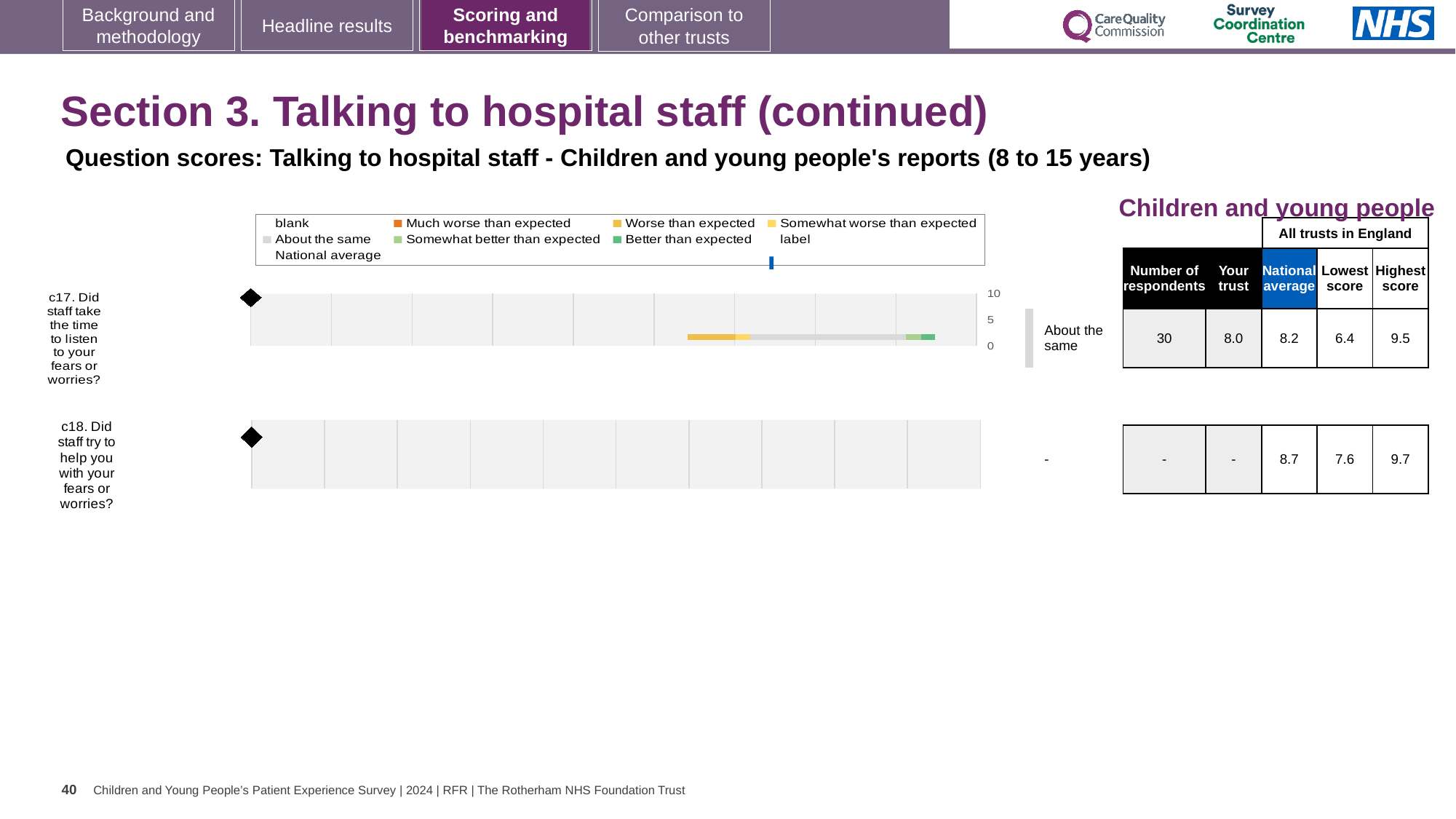
What is the lowest score among all trusts in England for question c17? 6.4 What is the highest score among all trusts in England for question c17? 9.5 For question c17, which is larger: the 'Your trust' score or the national average? National average Which benchmark category is shown for question c17 (Did staff take the time to listen to your fears or worries?)? About the same What is the highest score among all trusts in England for question c18? 9.7 What type of chart is used to show the question scores? bar chart How many survey questions are plotted in the chart? 2 What is the national average score for question c18 (Did staff try to help you with your fears or worries?)? 8.7 What is the difference between the highest score and the lowest score for question c17? 3.1 What is the 'Your trust' score for question c17? 8.0 What is the national average score for question c17? 8.2 How many respondents answered question c17? 30